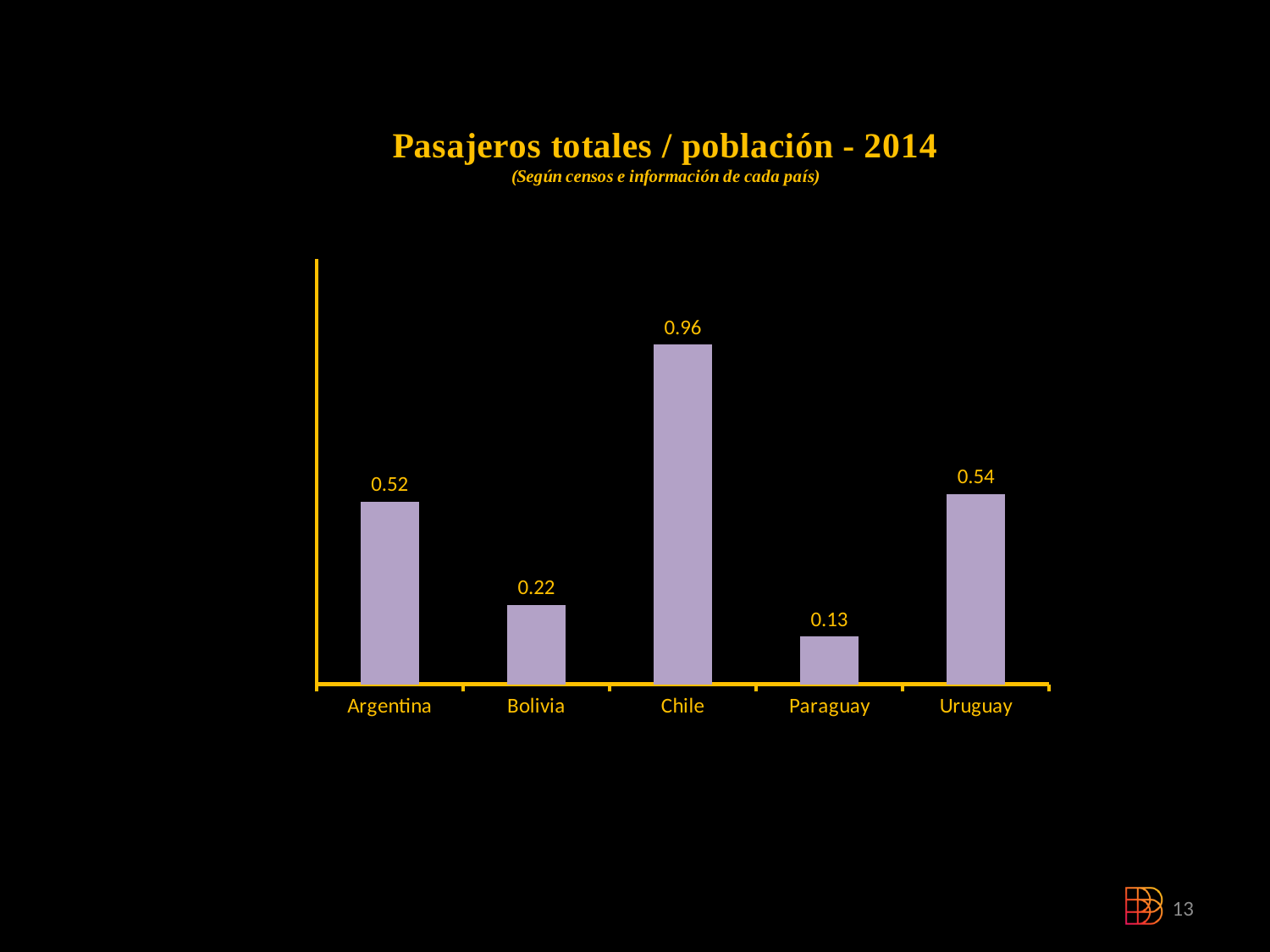
What is the title of the chart? Pasajeros totales / población - 2014 What is the value for Chile? 0.96 What is the value for Paraguay? 0.13 What is the difference between the values for Chile and Uruguay? 0.42 Which country has the highest value? Chile How many countries are shown on the chart? 5 What is the value for Argentina? 0.52 What kind of chart is this? Bar chart What is the value for Bolivia? 0.22 Which is larger, the value for Uruguay or the value for Argentina? Uruguay What is the difference between the values for Bolivia and Paraguay? 0.09 Which country has the lowest value? Paraguay